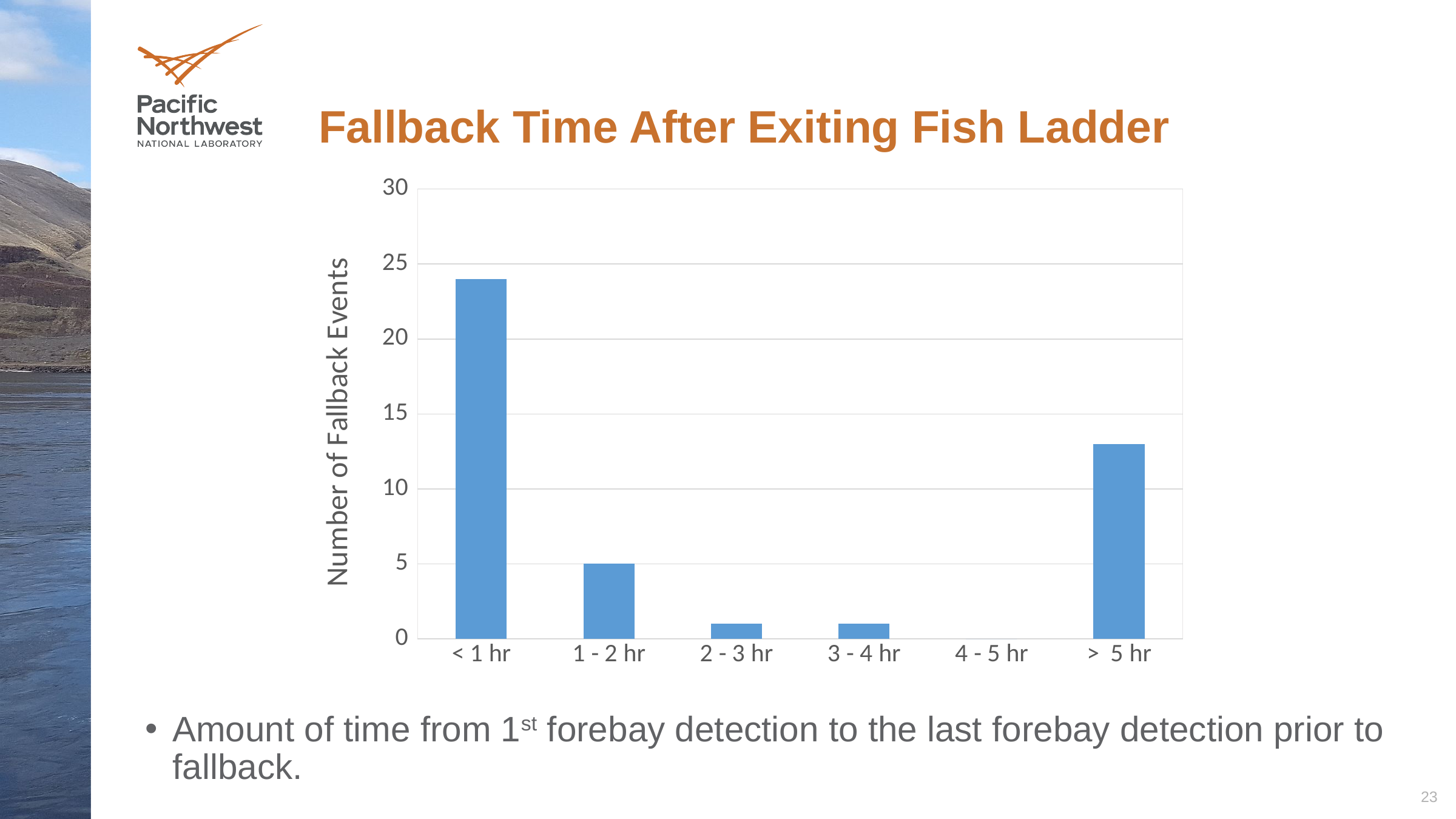
Which category has the lowest number of fallback events? 4 - 5 hr Is the value for < 1 hr greater or less than 20? greater How many fallback events are shown for the 1 - 2 hr category? 5 Is the value for > 5 hr greater or less than 15? less Which has more fallback events, < 1 hr or > 5 hr? < 1 hr How many fallback events are shown for the 4 - 5 hr category? 0 How many categories are shown on the x axis of the chart? 6 What is the label on the y axis of the chart? Number of Fallback Events What is the title of the chart on the slide? Fallback Time After Exiting Fish Ladder Is the value for 2 - 3 hr greater or less than 5? less Which category has the highest number of fallback events? < 1 hr What type of chart is shown on the slide? bar chart